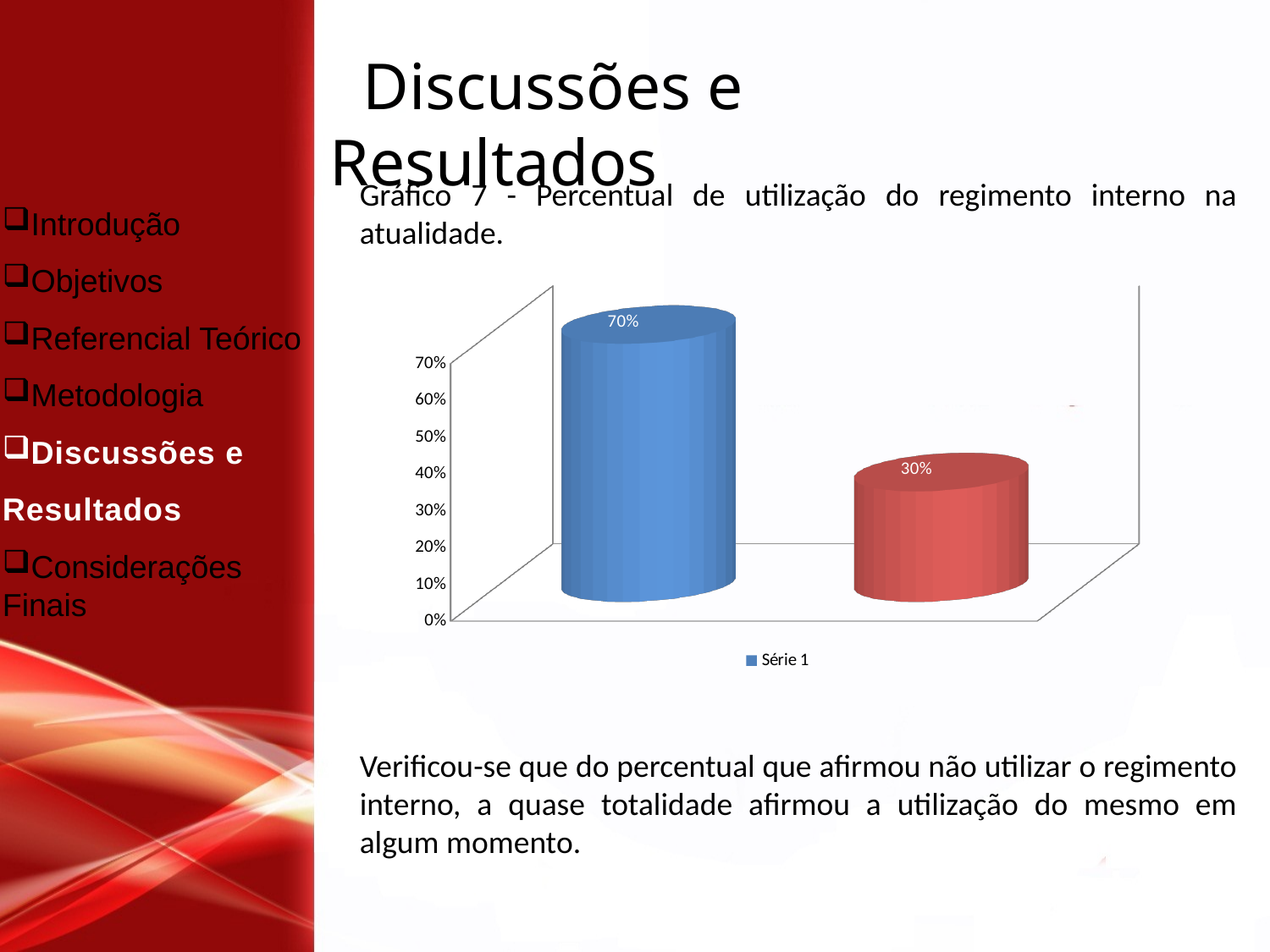
Is the value of the red bar larger or smaller than the value of the blue bar? smaller What kind of chart is shown on the slide? bar chart What value is shown on the red bar? 30% Which bar has the highest value, the blue one or the red one? the blue bar What is the difference between the values of the blue bar and the red bar? 40% How many bars are plotted in the chart? 2 How many series does the legend list? 1 Is the value of the red bar greater or less than 50%? less Which bar has the lowest value, the blue one or the red one? the red bar What is the highest value shown on the vertical axis? 70% What is the name of the series shown in the legend? Série 1 What value is shown on the blue bar? 70%